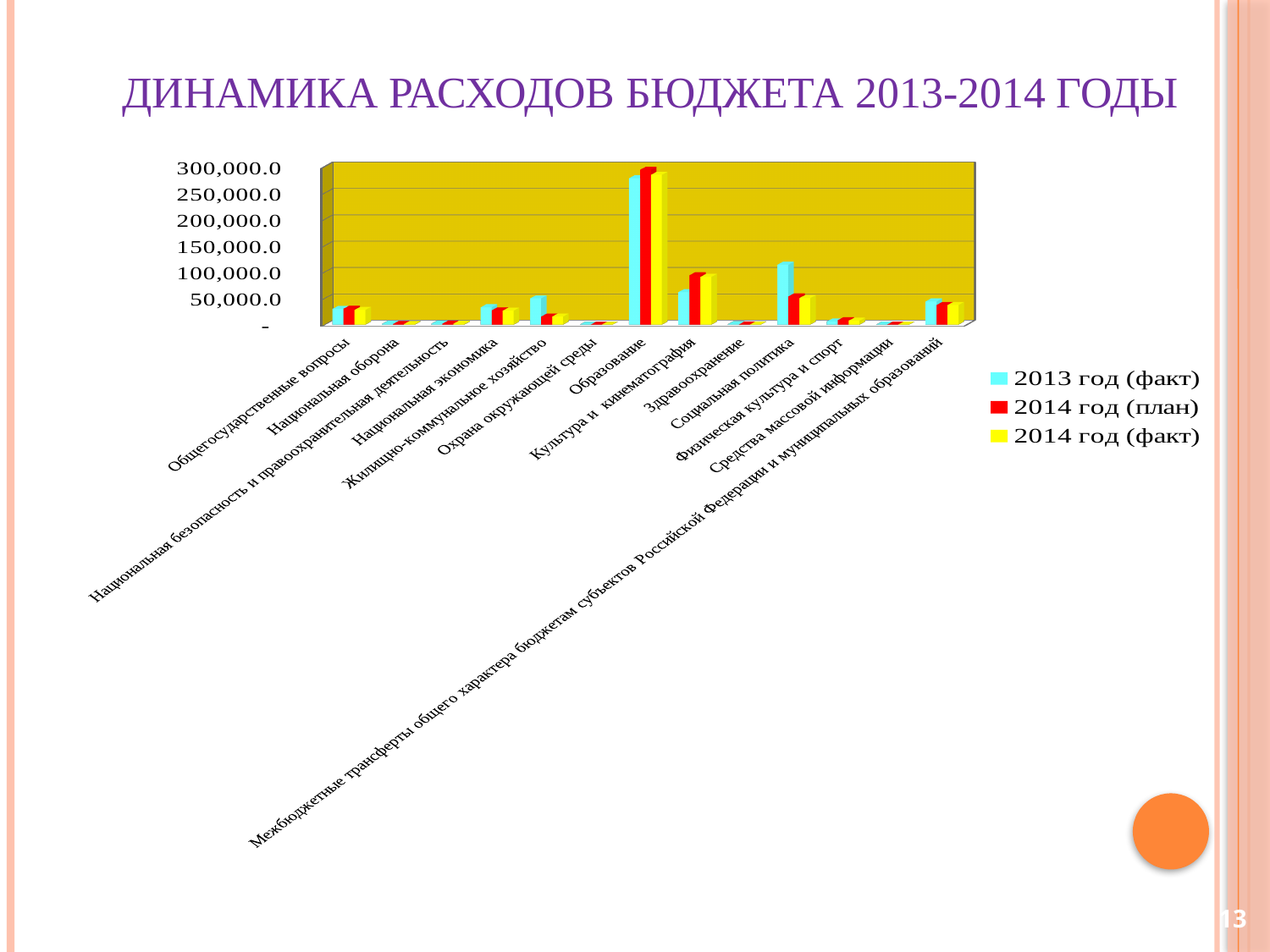
Is the 2014 год (факт) value for Национальная экономика greater or less than 50,000.0? less How many categories are shown on the x axis of the chart? 13 Is the 2014 год (план) value for Культура и кинематография greater or less than 50,000.0? greater What kind of chart is shown on the slide? bar chart Is the 2013 год (факт) value for Образование greater or less than 250,000.0? greater How many series does the legend list? 3 Which series is shown in red in the chart legend? 2014 год (план) Which is larger: the 2014 год (план) value for Образование or the 2014 год (план) value for Социальная политика? Образование Which category has the highest values in the chart? Образование For Социальная политика, which is larger: the 2013 год (факт) value or the 2014 год (факт) value? 2013 год (факт) What is the title of the slide containing the chart? ДИНАМИКА РАСХОДОВ БЮДЖЕТА 2013-2014 ГОДЫ